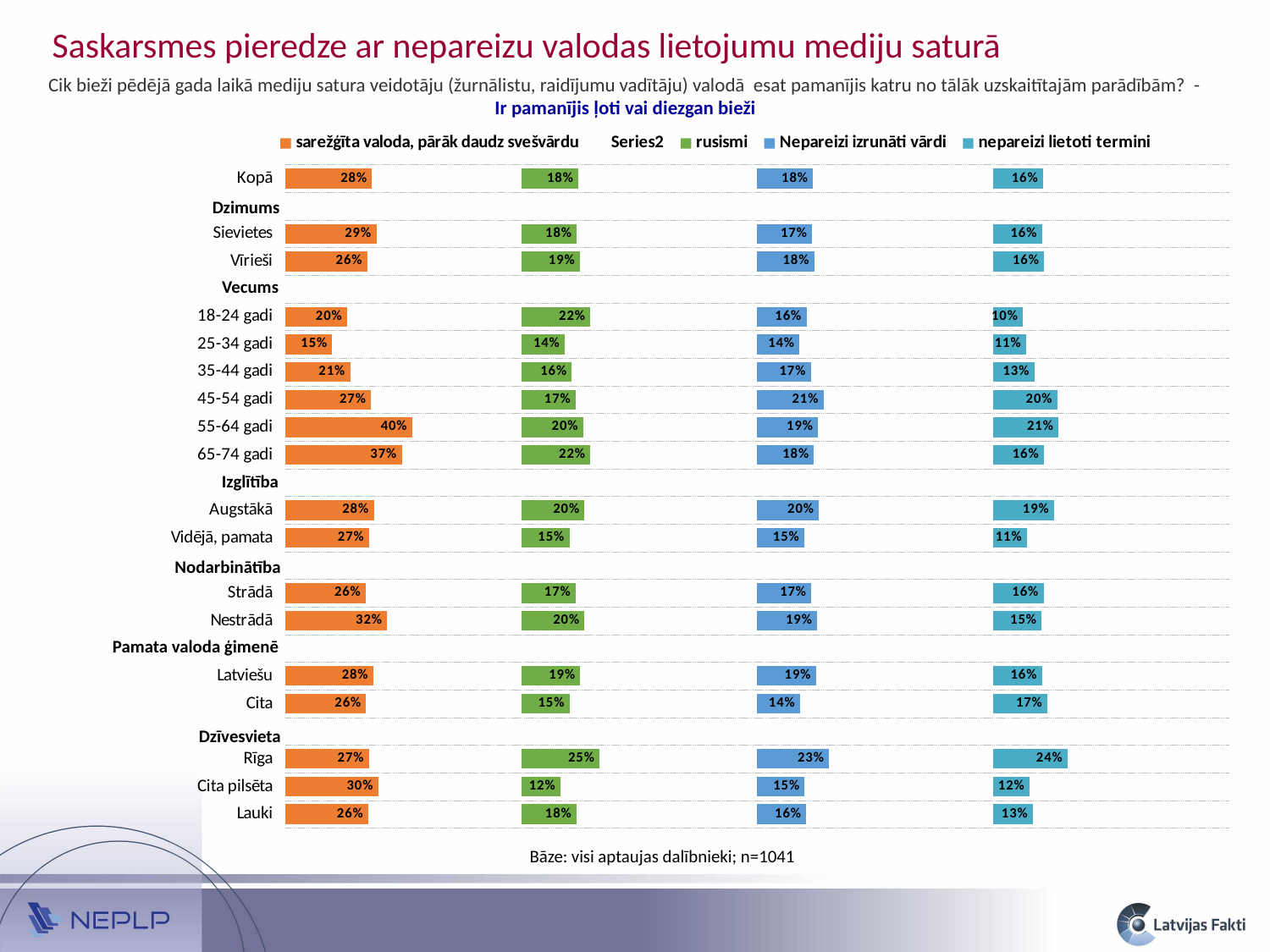
Which age group has the highest value in the "sarežģīta valoda, pārāk daudz svešvārdu" series? 55-64 gadi Which is larger in the "Nepareizi izrunāti vārdi" series: "Rīga" or "Lauki"? Rīga What is the difference between "Nestrādā" and "Strādā" in the "sarežģīta valoda, pārāk daudz svešvārdu" series? 6% How many entries does the chart legend list? 5 Which age group has the lowest value in the "nepareizi lietoti termini" series? 18-24 gadi What is the value for "55-64 gadi" in the "sarežģīta valoda, pārāk daudz svešvārdu" series? 40% What is the base (n) stated below the chart? n=1041 What is the value for "Rīga" in the "nepareizi lietoti termini" series? 24% What is the value for "Cita pilsēta" in the "rusismi" series? 12% What kind of chart is shown on the slide? Bar chart What is the difference between "Sievietes" and "Vīrieši" in the "sarežģīta valoda, pārāk daudz svešvārdu" series? 3% What is the value for "Kopā" in the "sarežģīta valoda, pārāk daudz svešvārdu" series? 28%